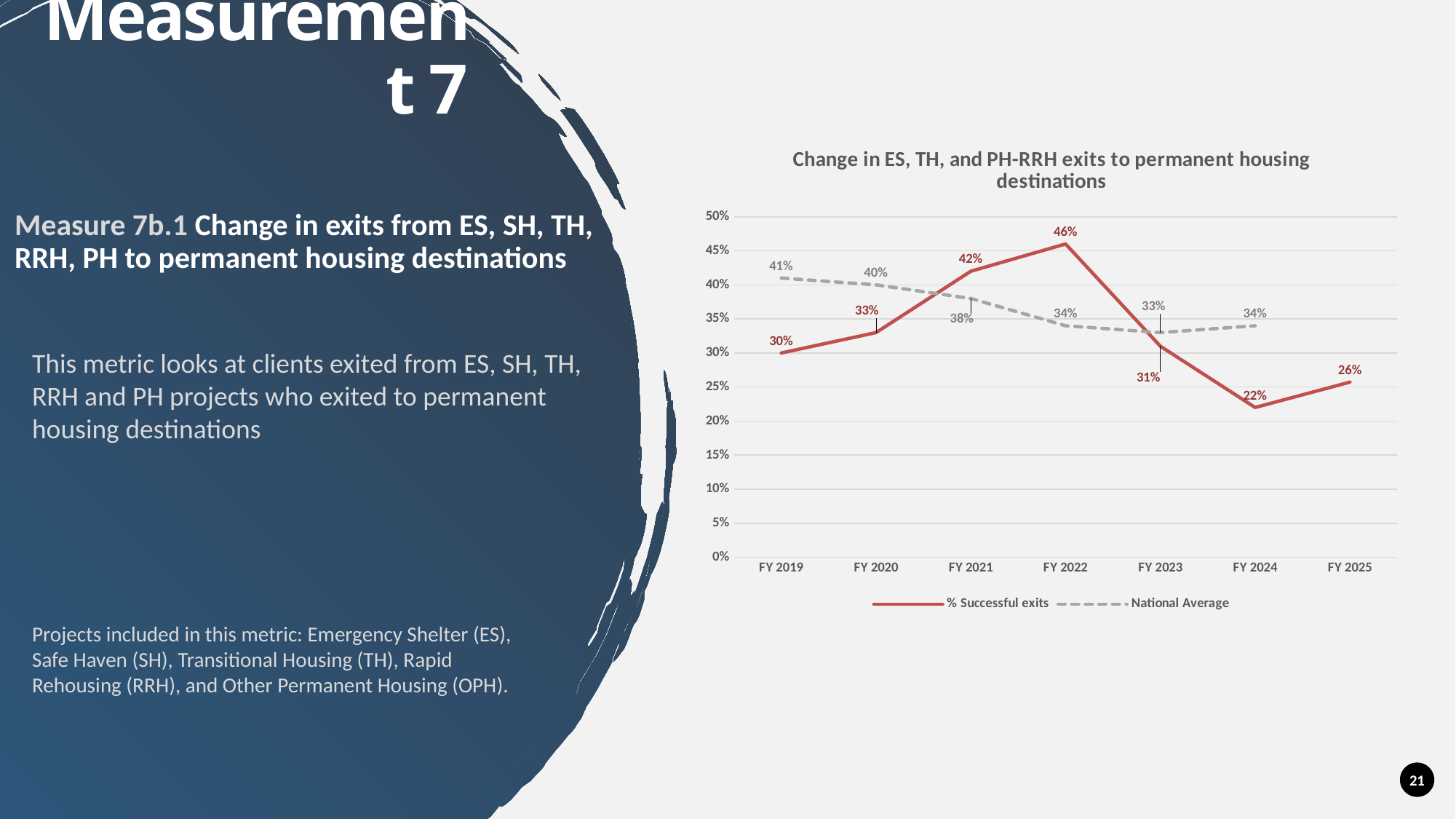
Which is larger in FY 2019: % Successful exits or National Average? National Average Which is larger in FY 2021: % Successful exits or National Average? % Successful exits What is the difference between the % Successful exits values for FY 2022 and FY 2024? 24% How many fiscal years are shown on the x axis? 7 What is the % Successful exits value for FY 2022? 46% What is the title of the chart? Change in ES, TH, and PH-RRH exits to permanent housing destinations What is the National Average value for FY 2019? 41% In which fiscal year is the % Successful exits value the lowest? FY 2024 In which fiscal year is the % Successful exits value the highest? FY 2022 How many series does the legend list? 2 What kind of chart is shown on the slide? Line chart Does the National Average rise or fall from FY 2019 to FY 2023? Fall